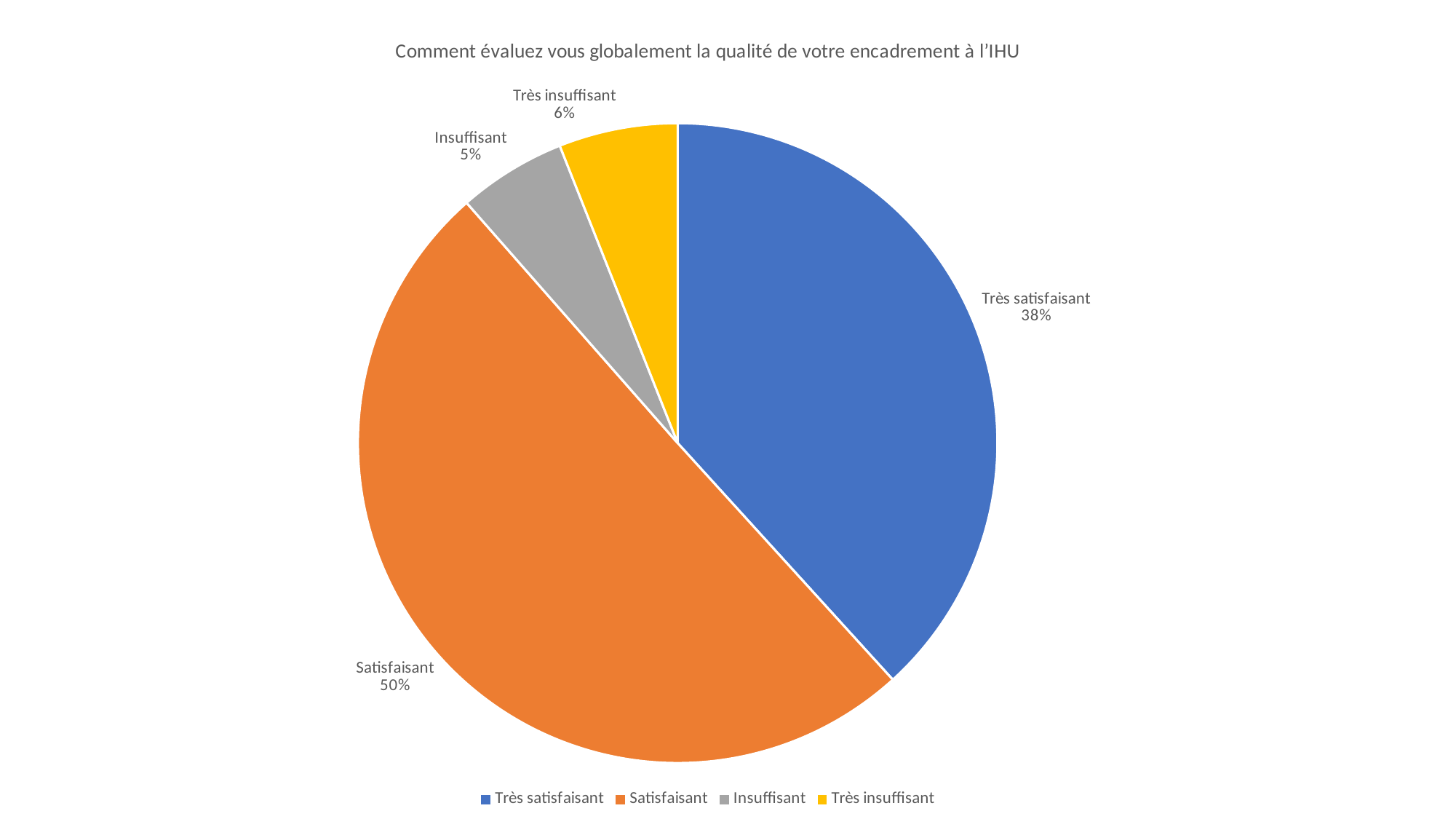
What colour is the Satisfaisant slice? Orange What is the value shown for Très satisfaisant? 38% What is the value shown for Très insuffisant? 6% Which category has the largest slice? Satisfaisant How many categories are shown in the pie chart? 4 What share of the pie does Satisfaisant represent? 50% What is the title of the chart? Comment évaluez vous globalement la qualité de votre encadrement à l'IHU What is the difference between the Satisfaisant and Très satisfaisant shares? 12% Which category has the smallest slice? Insuffisant Which is larger, Très satisfaisant or Très insuffisant? Très satisfaisant What kind of chart is shown on the slide? Pie chart What is the value shown for Insuffisant? 5%